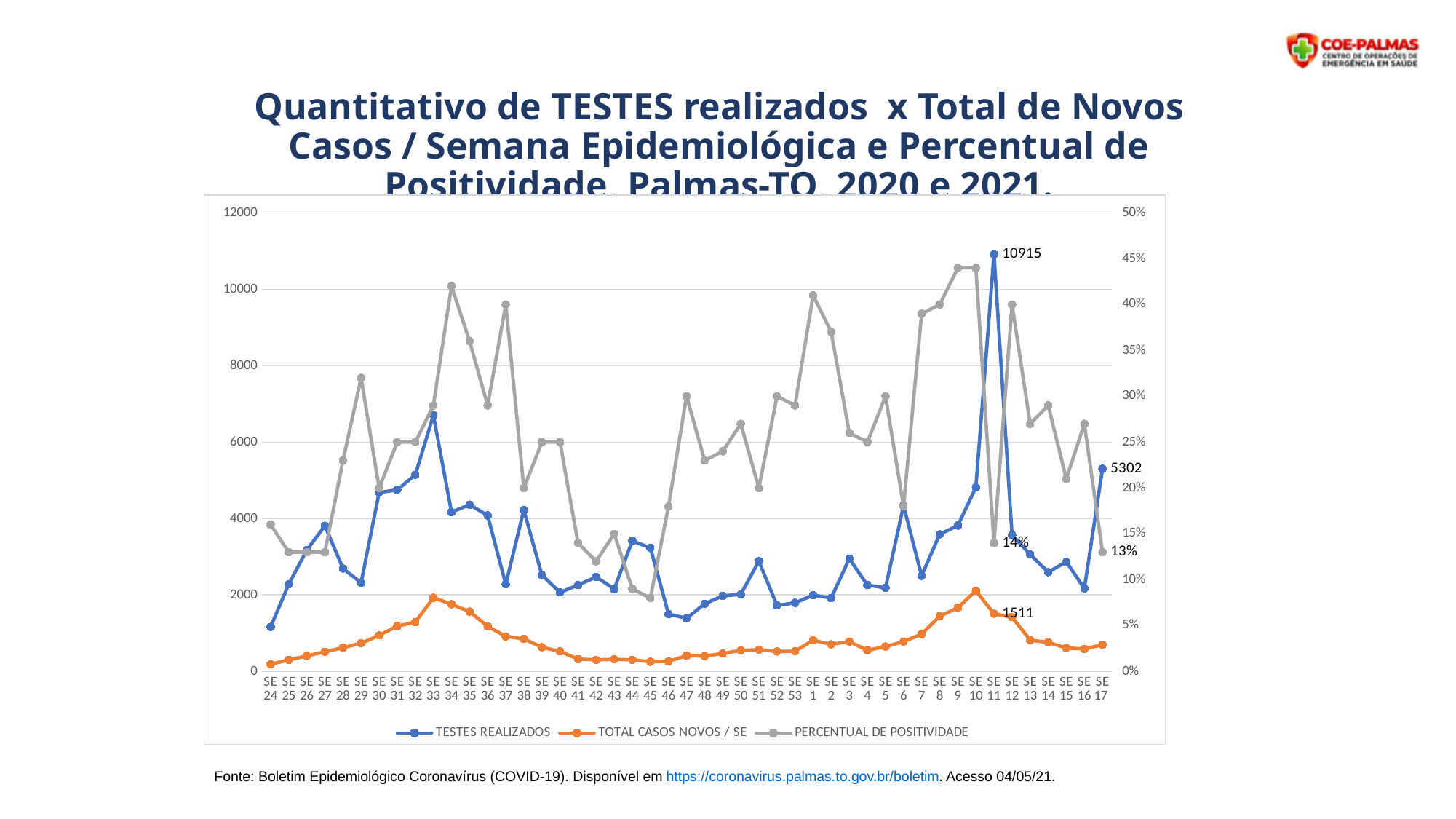
Which series is drawn in orange? TOTAL CASOS NOVOS / SE What is the PERCENTUAL DE POSITIVIDADE at SE 17? 13% What kind of chart is shown on the slide? line chart How many series does the legend list? 3 Is the PERCENTUAL DE POSITIVIDADE at SE 34 greater or less than 40%? greater What is the difference between TESTES REALIZADOS at SE 11 and at SE 17? 5613 What is the value of TOTAL CASOS NOVOS / SE at SE 11? 1511 What is the value of TESTES REALIZADOS at SE 17? 5302 Is the value of TOTAL CASOS NOVOS / SE at SE 45 greater or less than 1000? less In which epidemiological week is TESTES REALIZADOS highest? SE 11 What is the value of TESTES REALIZADOS at SE 11? 10915 Is the value of TESTES REALIZADOS at SE 33 greater or less than 6000? greater